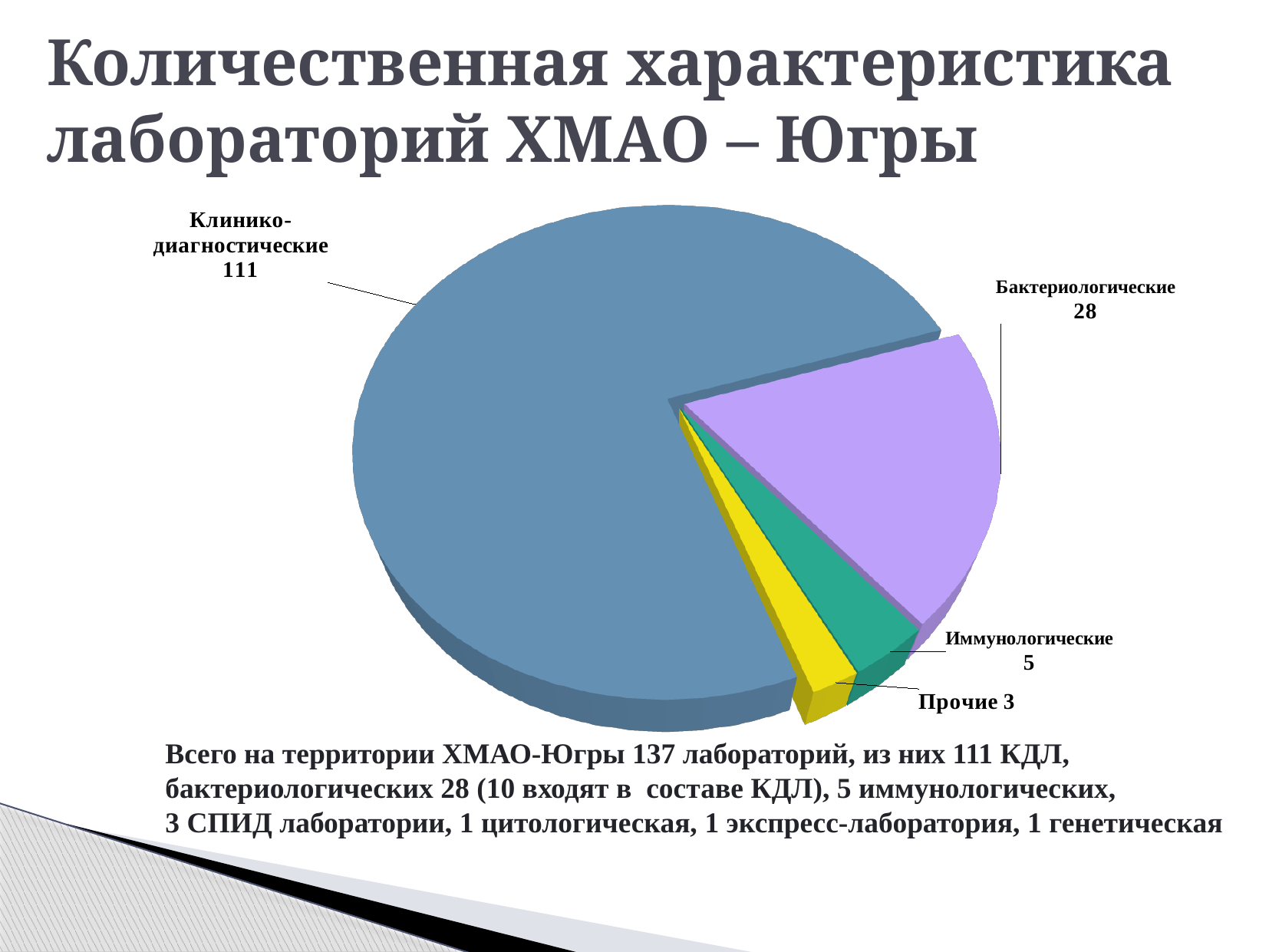
How many Клинико-диагностические laboratories does the pie chart show? 111 What colour is the Бактериологические slice? Purple Which is larger, Бактериологические or Иммунологические? Бактериологические What type of chart is shown on the slide? Pie chart What is the value shown for the Бактериологические slice? 28 What is the value of the Прочие slice? 3 What value is labelled for Иммунологические? 5 What is the difference between the Иммунологические and Прочие values? 2 Which category has the smallest slice of the pie? Прочие How many slices does the pie chart have? 4 Which category has the largest slice of the pie? Клинико-диагностические What is the difference between the Клинико-диагностические and Бактериологические values? 83